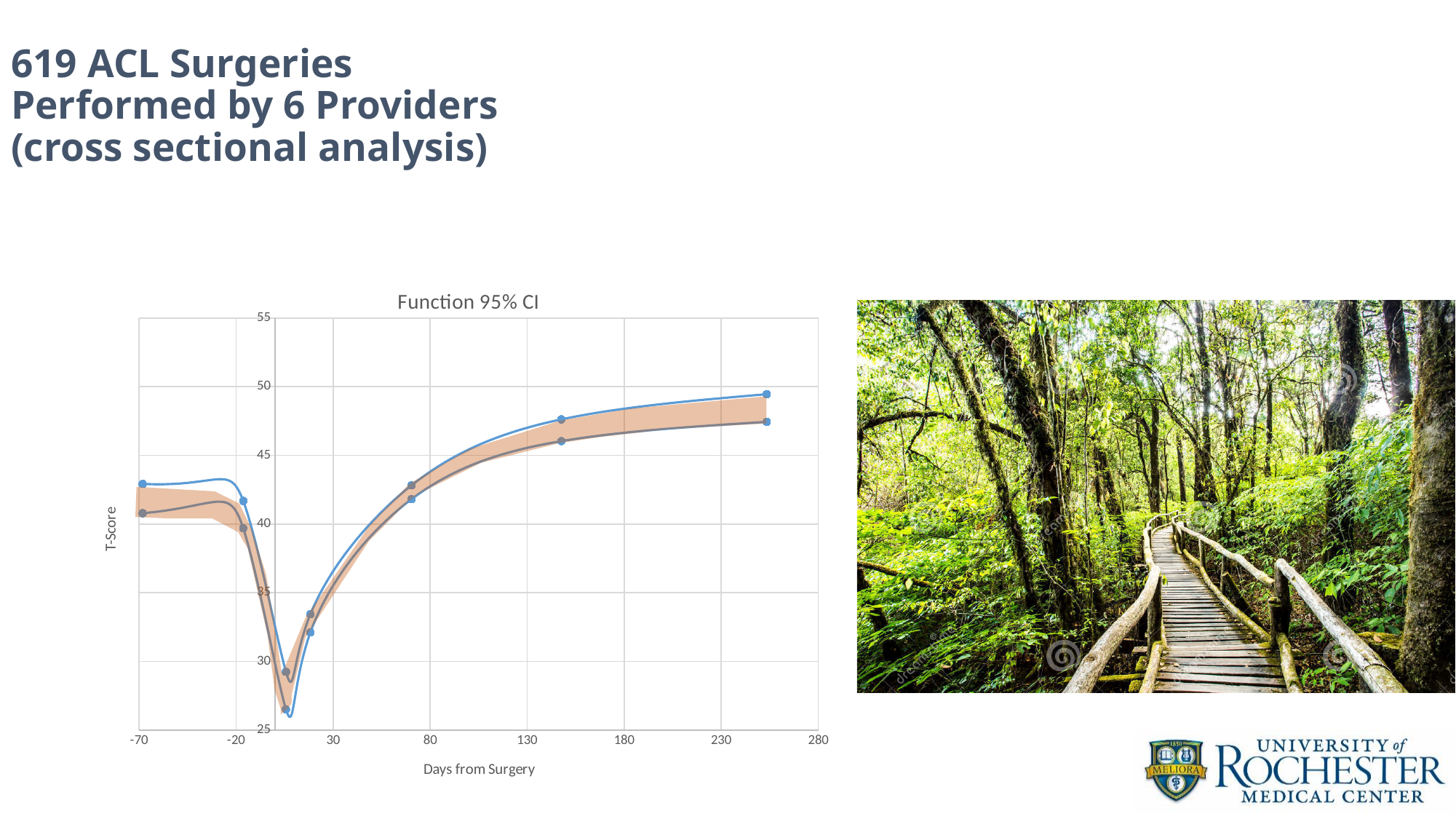
Is the value of the upper line at about 255 days from surgery greater or less than 45? greater What is the label of the x axis of the chart? Days from Surgery What is the highest value shown on the x axis of the chart? 280 What is the title of the chart on the slide? Function 95% CI Is the value of the lower line at about 70 days from surgery greater or less than 40? greater How many marked data points does each line in the chart have? 7 Is the value of the upper line at -70 days from surgery greater or less than 40? greater After the dip just after surgery, do the T-Score values rise or fall as days from surgery increase? rise What kind of chart is shown on the slide? line chart Around which point on the x axis do the lines reach their lowest T-Score? just after day 0 (shortly after surgery)